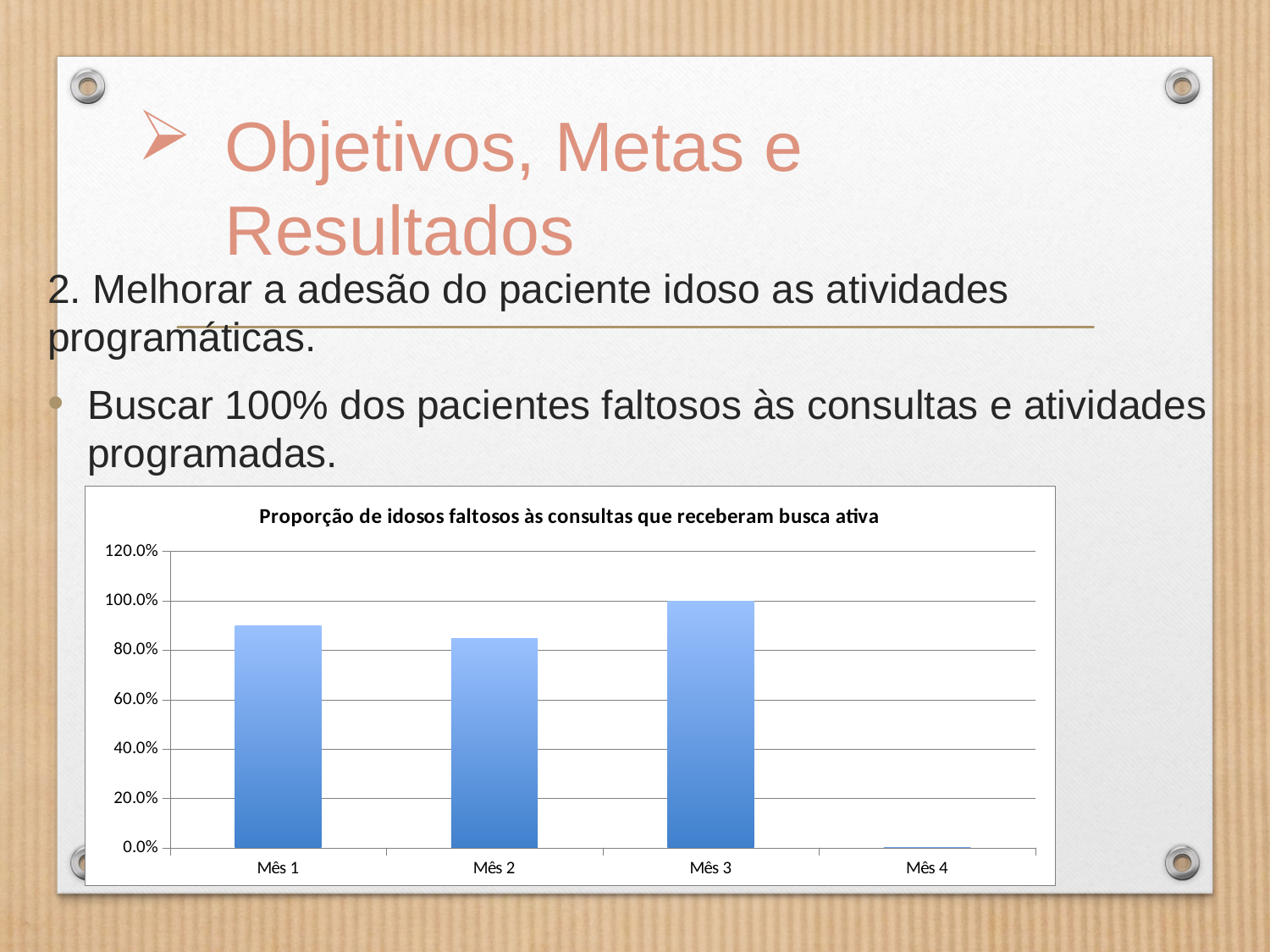
Which month has the highest value in the chart? Mês 3 What is the difference between the values for Mês 3 and Mês 4? 100.0% Is the value for Mês 2 greater or less than 100.0%? less Is the value for Mês 1 greater or less than 80.0%? greater What kind of chart is shown on the slide? bar chart Which is larger, the value for Mês 1 or the value for Mês 2? Mês 1 What is the title of the chart? Proporção de idosos faltosos às consultas que receberam busca ativa Which month has the lowest value in the chart? Mês 4 What is the value for Mês 4? 0.0% Is the value for Mês 1 greater or less than 100.0%? less How many months (categories) are shown on the x axis of the chart? 4 What is the value for Mês 3? 100.0%